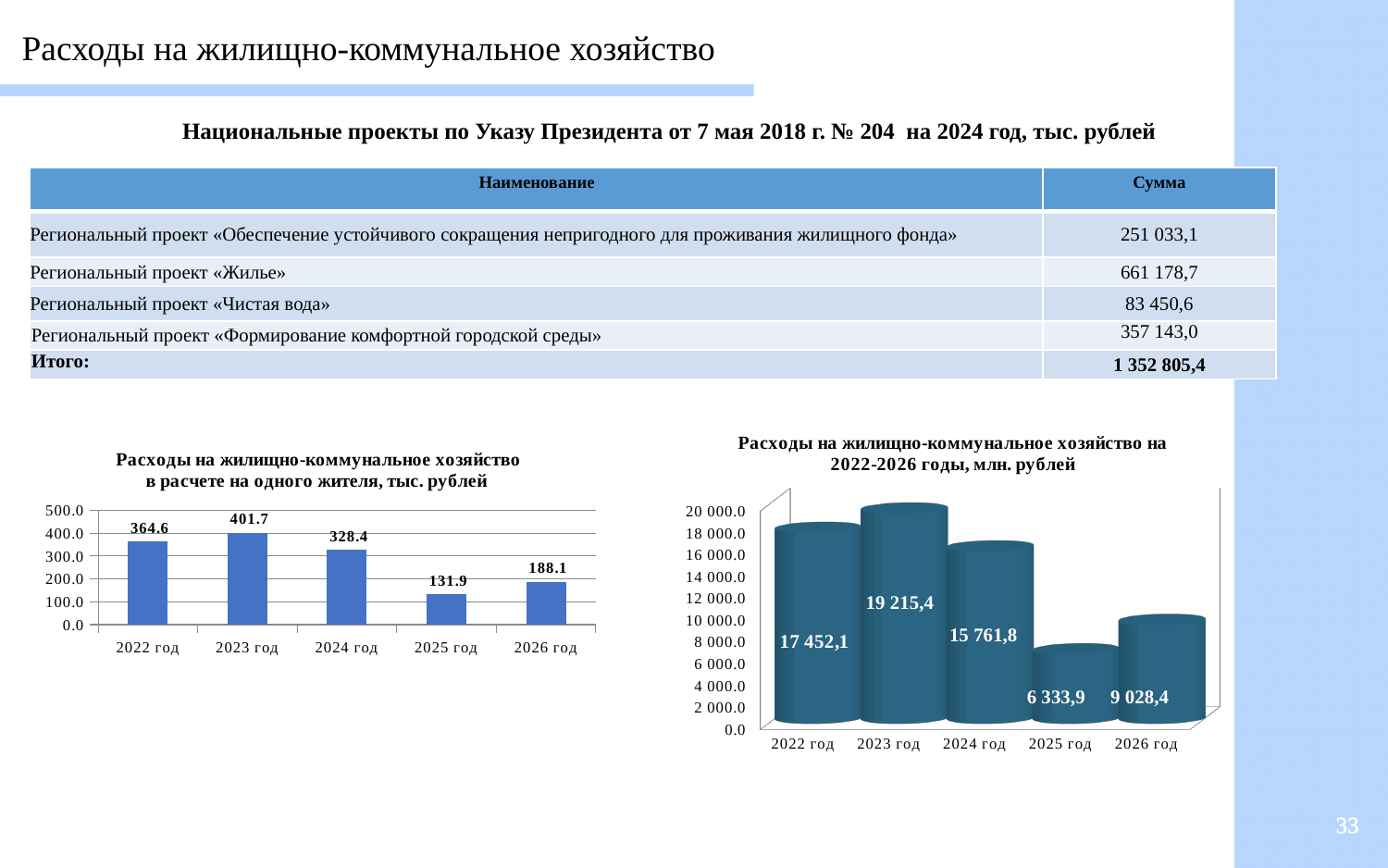
In the left chart (expenses per resident, thousand rubles), what is the difference between the values for 2022 год and 2024 год? 36.2 In the right chart (expenses for 2022-2026, million rubles), which is larger: the value for 2022 год or 2024 год? 2022 год In the left chart (expenses per resident, thousand rubles), which year has the lowest value? 2025 год In the right chart (expenses for 2022-2026, million rubles), which year has the lowest value? 2025 год In the left chart (expenses per resident, thousand rubles), which year has the highest value? 2023 год In the left chart (expenses per resident, thousand rubles), what is the value for 2023 год? 401.7 In the left chart (expenses per resident, thousand rubles), what is the value for 2025 год? 131.9 In the right chart (expenses for 2022-2026, million rubles), do the values rise or fall from 2023 год to 2025 год? fall What type of chart is the right chart (expenses for 2022-2026, million rubles)? bar chart In the left chart (expenses per resident, thousand rubles), how many years are shown on the x axis? 5 In the right chart (expenses for 2022-2026, million rubles), what is the value for 2023 год? 19 215,4 In the right chart (expenses for 2022-2026, million rubles), what is the value for 2026 год? 9 028,4